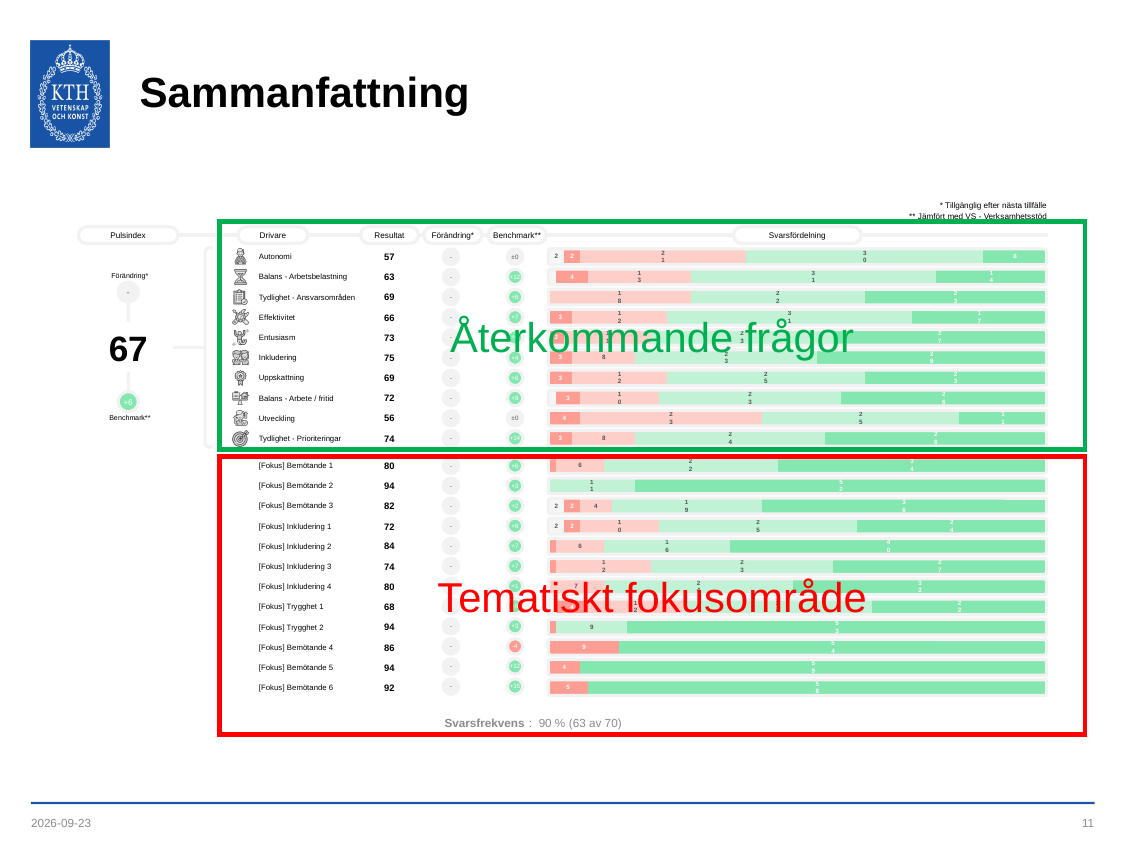
Which row in the Tematiskt fokusområde section has the lowest Resultat value? [Fokus] Trygghet 1 What is the difference between the Resultat values for Inkludering and Utveckling in the Återkommande frågor section? 19 What is the Pulsindex value shown on the left of the slide? 67 Which has a higher Resultat value, Entusiasm or Effektivitet? Entusiasm Which driver in the Återkommande frågor section has the lowest Resultat value? Utveckling What is the Resultat value for [Fokus] Trygghet 1? 68 What is the Resultat value for Autonomi in the Återkommande frågor section? 57 What is the difference between the Resultat values for [Fokus] Bemötande 2 and [Fokus] Trygghet 1? 26 What is the Svarsfrekvens (response rate) shown at the bottom of the table? 90 % (63 av 70) How many rows are listed in the Tematiskt fokusområde section? 12 Which driver in the Återkommande frågor section has the highest Resultat value? Inkludering How many driver rows are listed in the Återkommande frågor section? 10